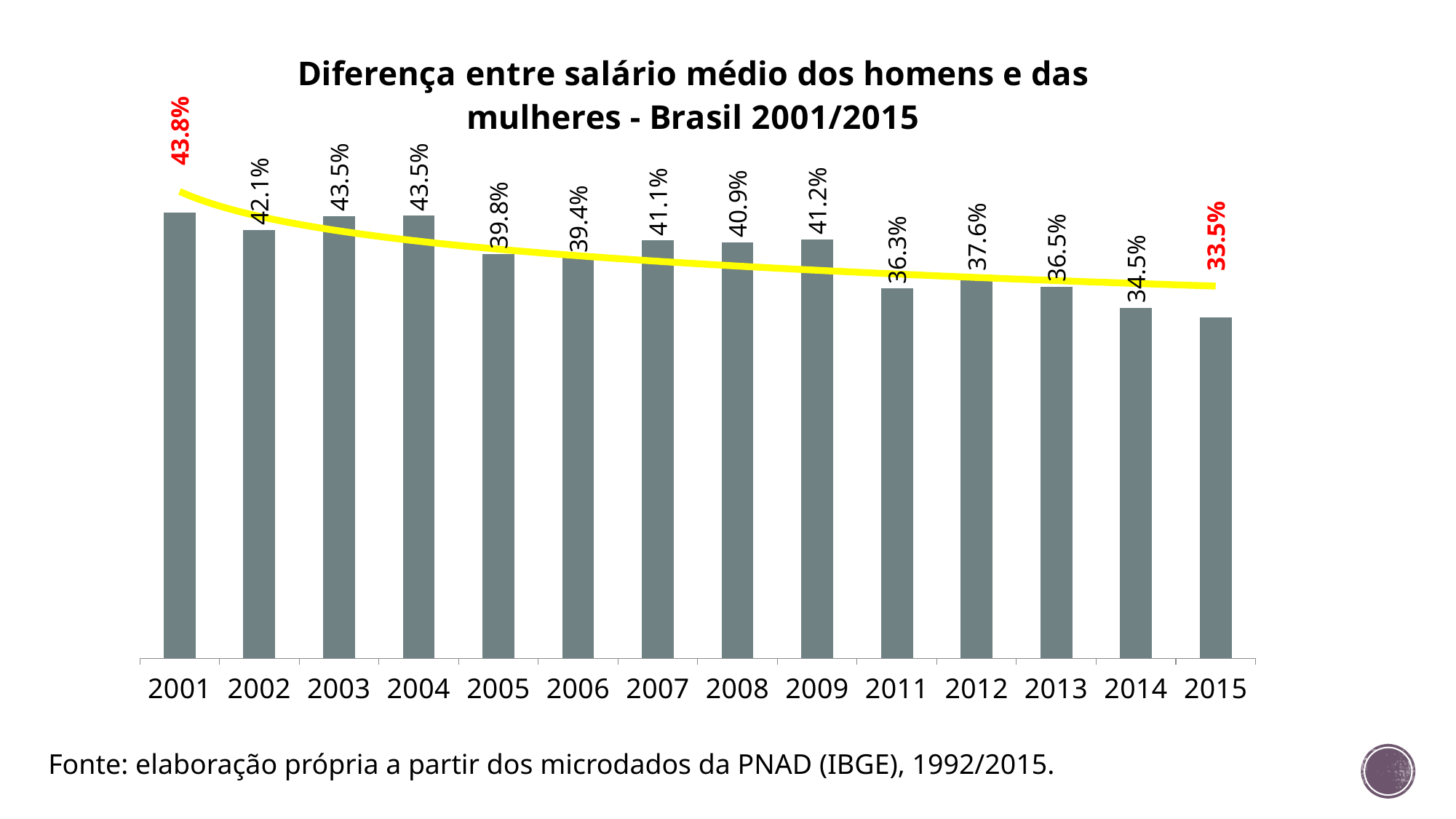
What is the difference between the values for 2001 and 2015? 10.3% Which year has the lowest value? 2015 What is the value for 2001? 43.8% What is the value for 2011? 36.3% Which is larger, the value for 2005 or the value for 2007? 2007 How many years are shown on the x axis? 14 Do the values generally rise or fall from 2001 to 2015? Fall Which year has the highest value? 2001 What is the value for 2009? 41.2% What is the difference between the values for 2012 and 2013? 1.1% What kind of chart is this? Bar chart What is the value for 2015? 33.5%